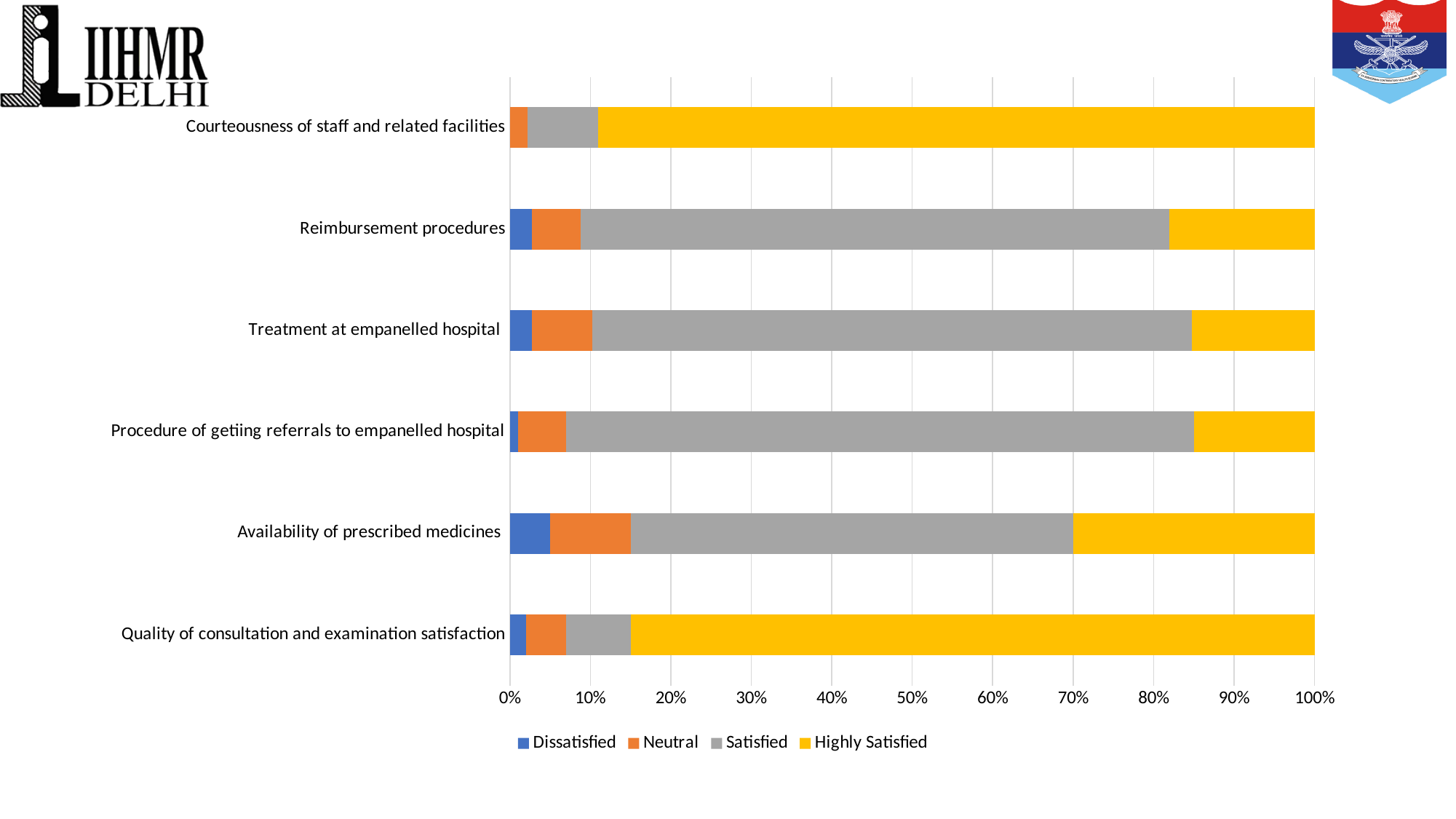
Which colour represents the Highly Satisfied series? yellow Is the Dissatisfied value for Availability of prescribed medicines greater or less than 10%? less Which category has the largest Highly Satisfied segment? Courteousness of staff and related facilities What are the four series named in the legend? Dissatisfied, Neutral, Satisfied, Highly Satisfied Which has the larger Highly Satisfied segment: Availability of prescribed medicines or Reimbursement procedures? Availability of prescribed medicines Is the Satisfied value for Availability of prescribed medicines greater or less than 50%? greater Which category has the largest Dissatisfied segment? Availability of prescribed medicines How many series does the legend list? 4 What is the total of the stacked bar for Reimbursement procedures? 100% How many categories are plotted on the chart? 6 Is the Highly Satisfied value for Courteousness of staff and related facilities greater or less than 80%? greater What kind of chart is shown on the slide? bar chart